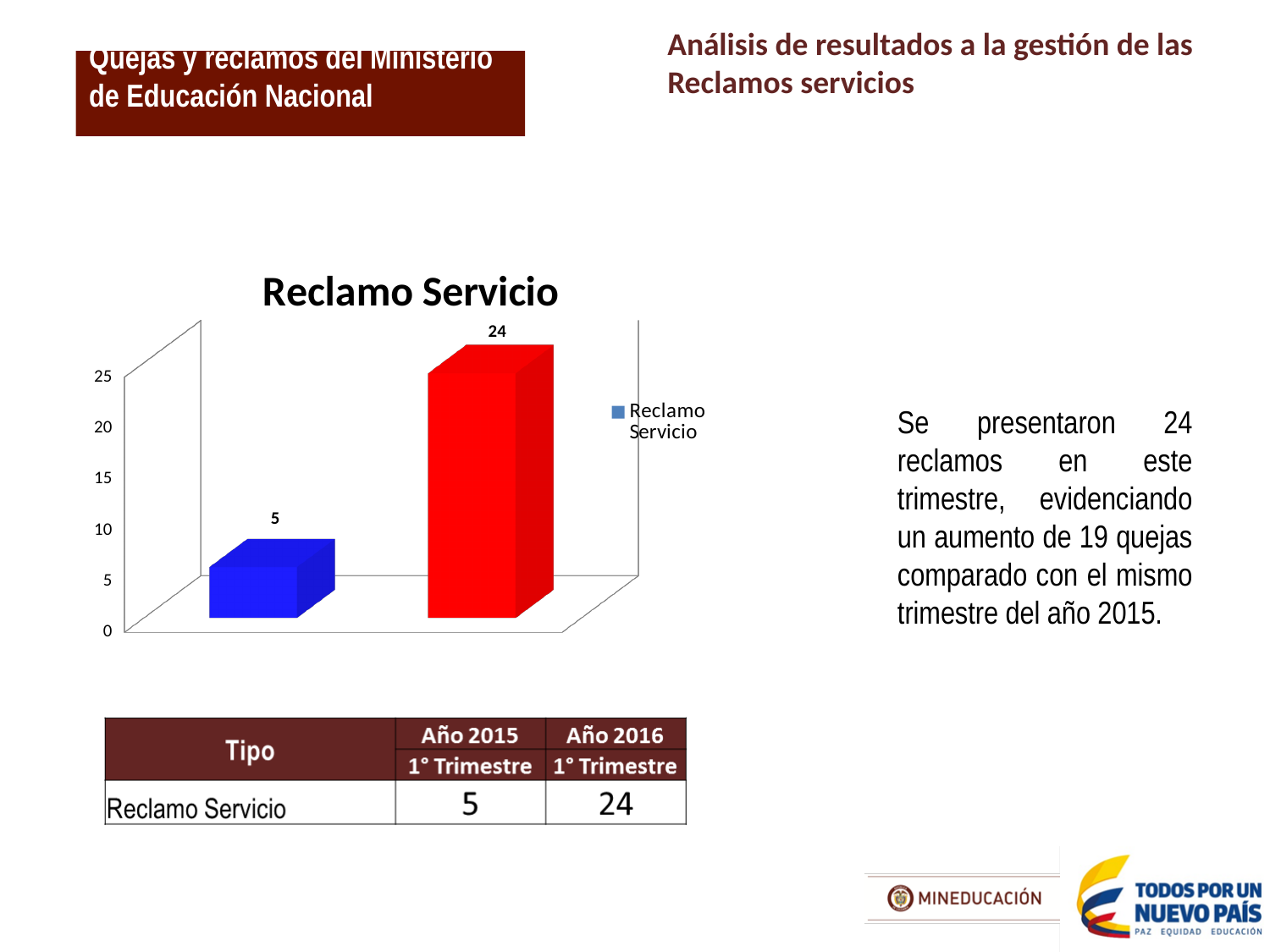
How many series does the legend of the Reclamo Servicio chart list? 1 What is the difference between the values of the red bar and the blue bar in the Reclamo Servicio chart? 19 What is the title of the chart? Reclamo Servicio What value is labelled on the blue bar in the Reclamo Servicio chart? 5 What value is labelled on the red bar in the Reclamo Servicio chart? 24 Which bar in the Reclamo Servicio chart has the lowest value, the blue one or the red one? the blue bar What type of chart is shown on the slide? bar chart Is the value of the blue bar in the Reclamo Servicio chart greater or less than 10? less According to the table below the chart, what is the Reclamo Servicio value for the 1° Trimestre of Año 2016? 24 How many bars are plotted in the Reclamo Servicio chart? 2 Which bar in the Reclamo Servicio chart has the highest value, the blue one or the red one? the red bar Is the value of the red bar in the Reclamo Servicio chart greater or less than 20? greater